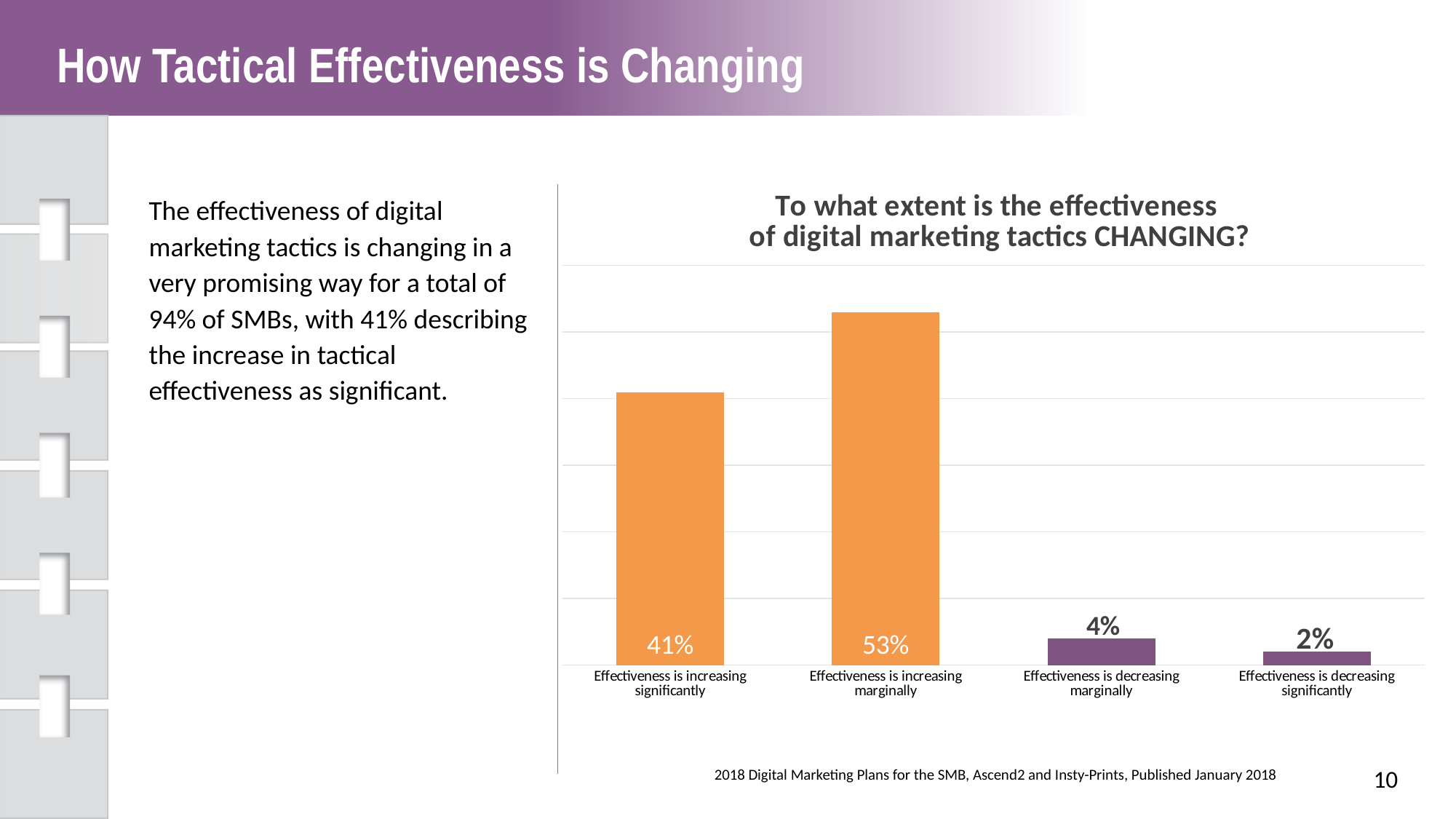
What percentage of respondents say effectiveness is decreasing marginally? 4% Which category has the lowest value? Effectiveness is decreasing significantly Which is larger: the value for 'Effectiveness is decreasing marginally' or 'Effectiveness is decreasing significantly'? Effectiveness is decreasing marginally What percentage of respondents say effectiveness is increasing marginally? 53% What percentage of respondents say effectiveness is increasing significantly? 41% What kind of chart is shown on the slide? Bar chart Which category has the highest value? Effectiveness is increasing marginally What is the difference between the values for 'Effectiveness is increasing marginally' and 'Effectiveness is increasing significantly'? 12% What is the title of the chart? To what extent is the effectiveness of digital marketing tactics CHANGING? How many categories are shown in the chart? 4 What percentage of respondents say effectiveness is decreasing significantly? 2% What colour are the bars for the two 'decreasing' categories? Purple